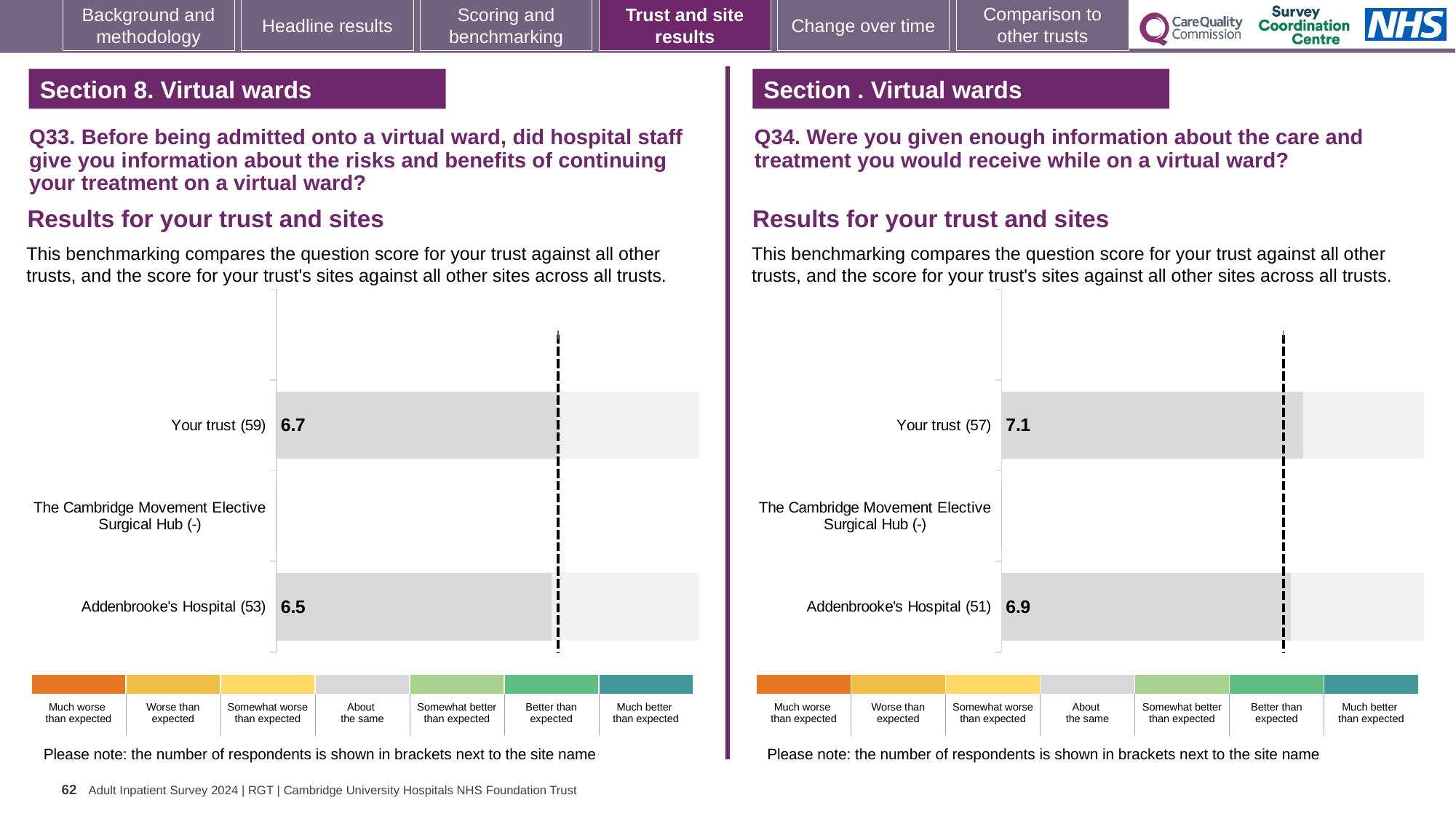
What kind of chart is the Q34 chart on the right? Bar chart In the Q33 chart on the left, how many respondents are shown in brackets for Addenbrooke's Hospital? 53 In the Q34 chart on the right, which category has no score bar shown? The Cambridge Movement Elective Surgical Hub (-) In the Q34 chart on the right, what is the score for Addenbrooke's Hospital (51)? 6.9 In the Q33 chart on the left, what is the difference between the score for Your trust (59) and the score for Addenbrooke's Hospital (53)? 0.2 In the Q33 chart on the left, what is the score for Your trust (59)? 6.7 In the Q34 chart on the right, which has the higher score: Your trust (57) or Addenbrooke's Hospital (51)? Your trust (57) In the Q33 chart on the left, what is the score for Addenbrooke's Hospital (53)? 6.5 In the Q34 chart on the right, what is the difference between the score for Your trust (57) and the score for Addenbrooke's Hospital (51)? 0.2 In the Q33 chart on the left, which has the higher score: Your trust (59) or Addenbrooke's Hospital (53)? Your trust (59) In the Q34 chart on the right, what is the score for Your trust (57)? 7.1 How many categories are listed on the vertical axis of the Q33 chart on the left? 3